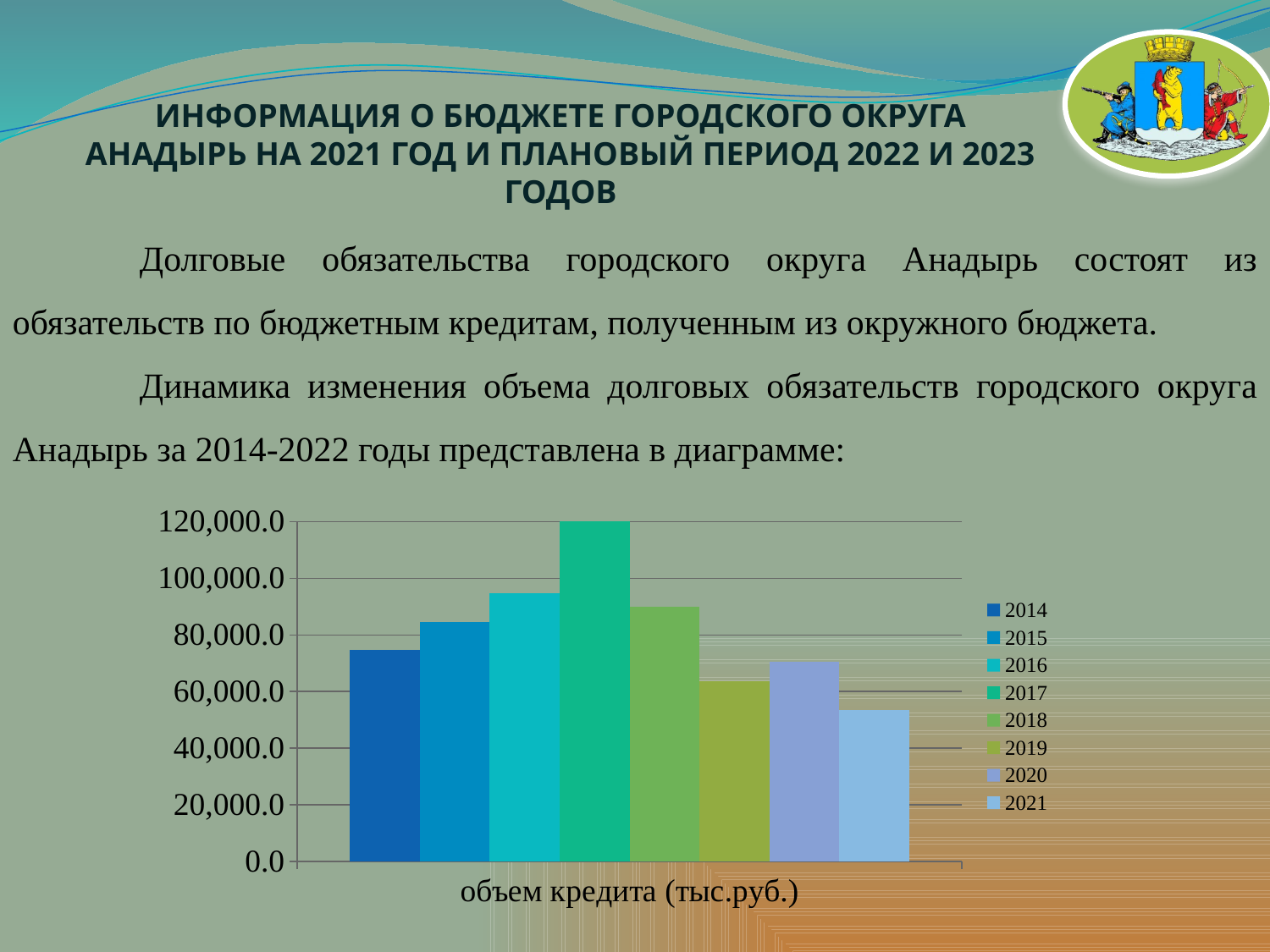
What kind of chart is shown on the slide? bar chart Which is larger, the value for 2018 or the value for 2020? 2018 What is the category label shown on the x axis of the chart? объем кредита (тыс.руб.) Is the value for 2014 greater or less than 80,000.0? less Do the values rise or fall from 2014 to 2017? rise Which year has the highest value in the chart? 2017 Is the value for 2021 greater or less than 60,000.0? less Which is larger, the value for 2015 or the value for 2019? 2015 Is the value for 2016 greater or less than 80,000.0? greater Which year has the lowest value in the chart? 2021 How many series does the legend list? 8